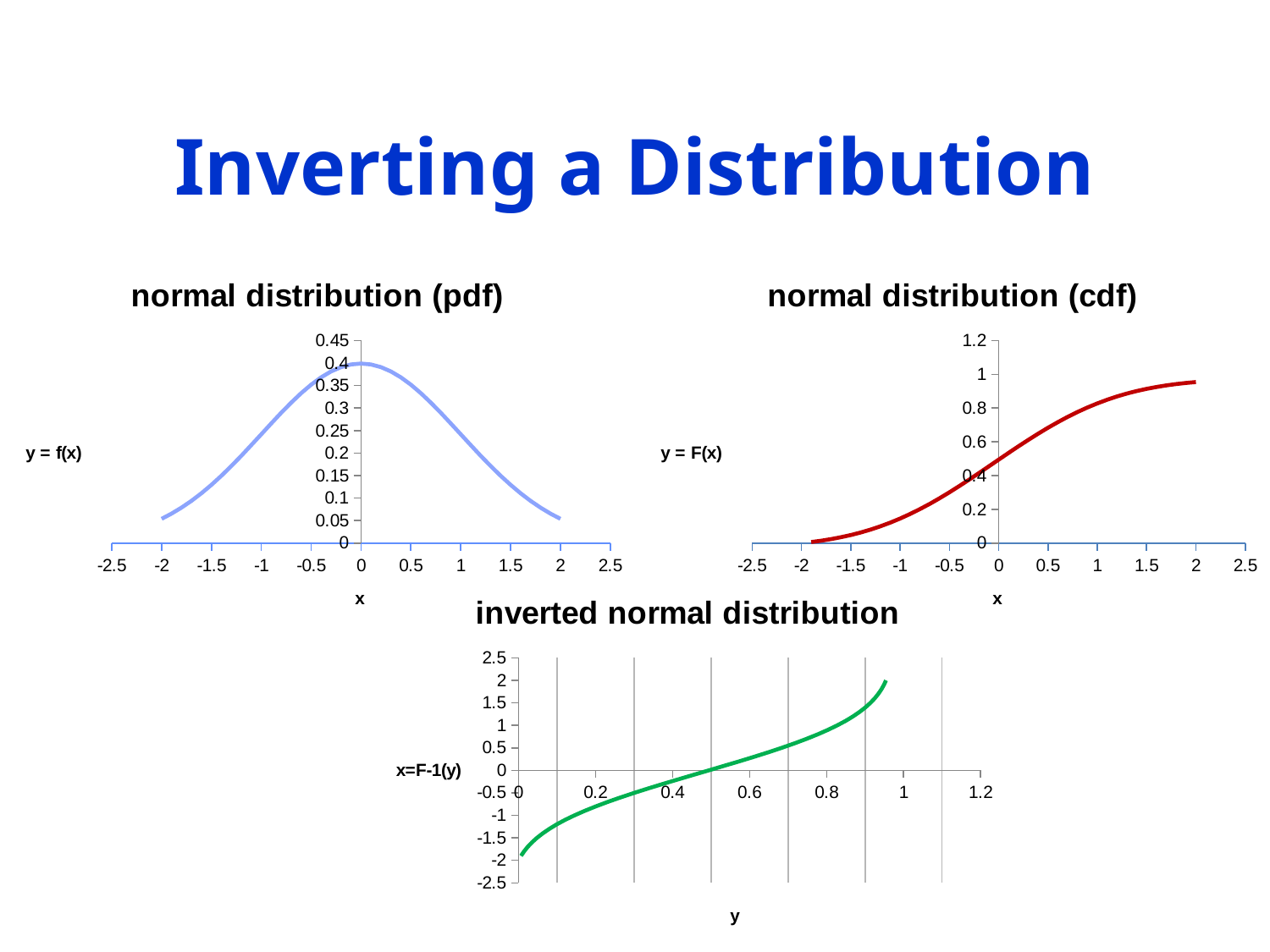
In the "inverted normal distribution" chart, is the value at y = 0.2 greater or less than 0? less What is the label on the vertical axis of the "inverted normal distribution" chart? x=F-1(y) In the "normal distribution (cdf)" chart, do the values rise or fall as x increases? rise How many charts are shown on the slide? 3 In the "normal distribution (cdf)" chart, is the value at x = -1.5 greater or less than 0.2? less In the "normal distribution (pdf)" chart, is the value at x = 0 greater or less than 0.3? greater What colour is the line in the "normal distribution (cdf)" chart? red What kind of chart is the "normal distribution (pdf)" chart? line chart In the "inverted normal distribution" chart, do the values rise or fall as y increases? rise In the "normal distribution (pdf)" chart, at which x value does the curve reach its highest point? 0